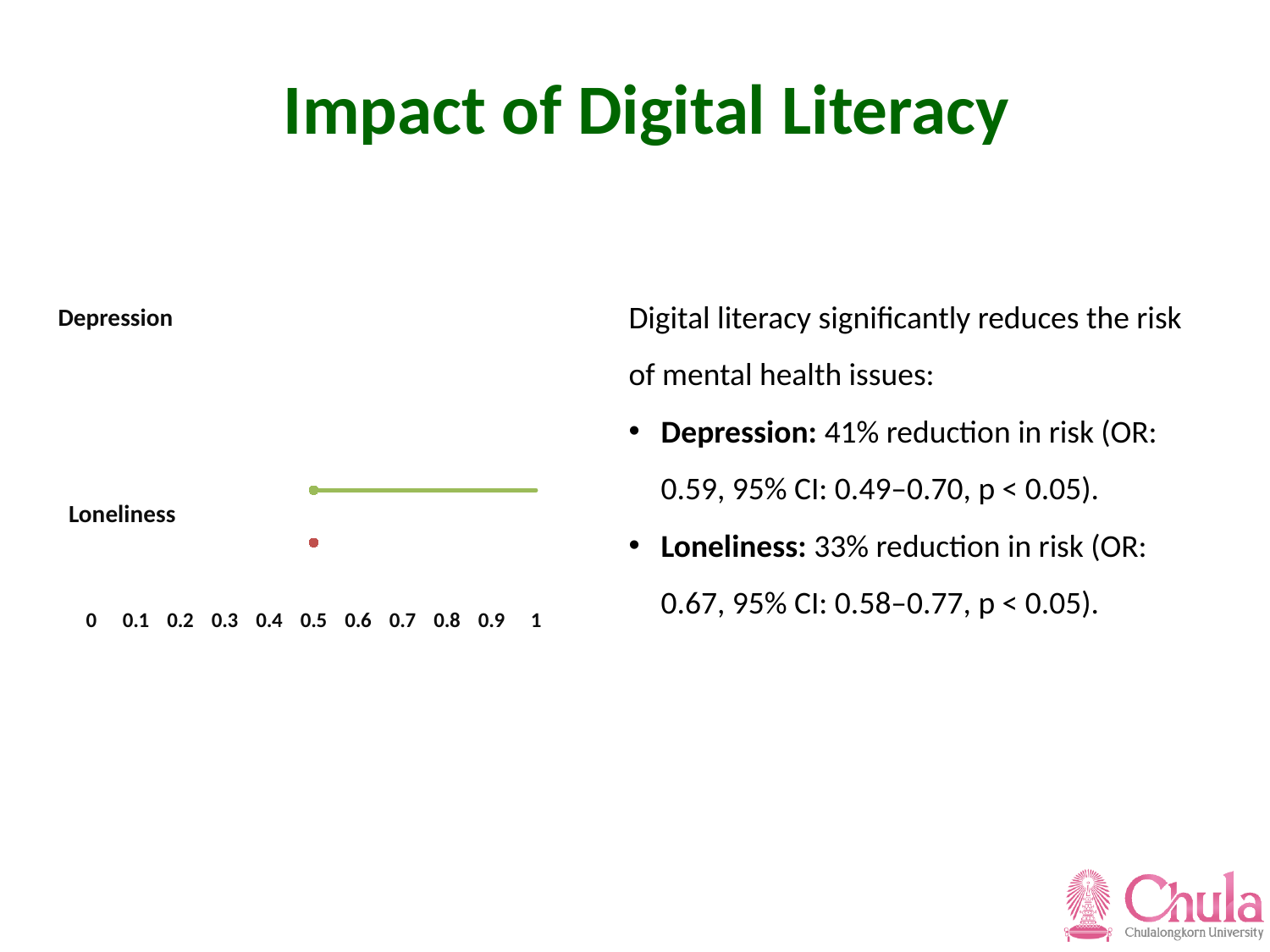
How many categories are labelled on the vertical axis of the chart? 2 What is the highest value shown on the chart's horizontal axis? 1 How many tick labels are printed along the chart's horizontal axis? 11 What are the two category labels shown on the chart? Depression and Loneliness What is the interval between consecutive tick labels on the chart's horizontal axis? 0.1 What is the lowest value shown on the chart's horizontal axis? 0 Which category label appears at the top of the chart? Depression